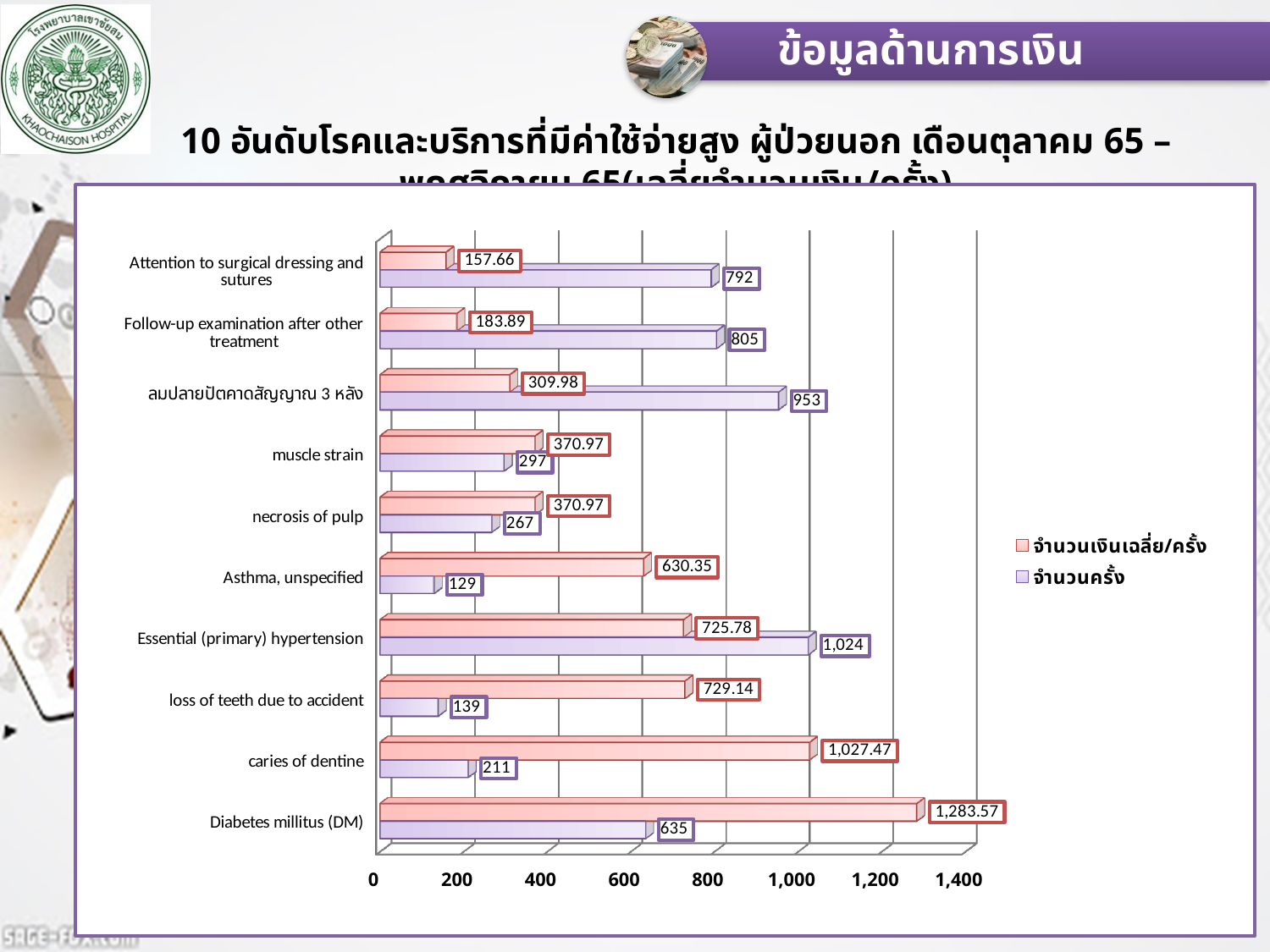
What is the difference between the average amount per visit (จำนวนเงินเฉลี่ย/ครั้ง) for Diabetes millitus (DM) and caries of dentine? 256.10 Which has a larger average amount per visit (จำนวนเงินเฉลี่ย/ครั้ง): caries of dentine or loss of teeth due to accident? caries of dentine What is the number of visits (จำนวนครั้ง) for Essential (primary) hypertension? 1,024 How many series does the legend list? 2 How many categories are shown on the chart? 10 Which category has the highest average amount per visit (จำนวนเงินเฉลี่ย/ครั้ง)? Diabetes millitus (DM) What is the number of visits (จำนวนครั้ง) for Asthma, unspecified? 129 What is the average amount per visit (จำนวนเงินเฉลี่ย/ครั้ง) for Diabetes millitus (DM)? 1,283.57 What kind of chart is shown on the slide? Bar chart Which category has the highest number of visits (จำนวนครั้ง)? Essential (primary) hypertension Which category has the lowest number of visits (จำนวนครั้ง)? Asthma, unspecified What is the difference in number of visits (จำนวนครั้ง) between Follow-up examination after other treatment and Attention to surgical dressing and sutures? 13